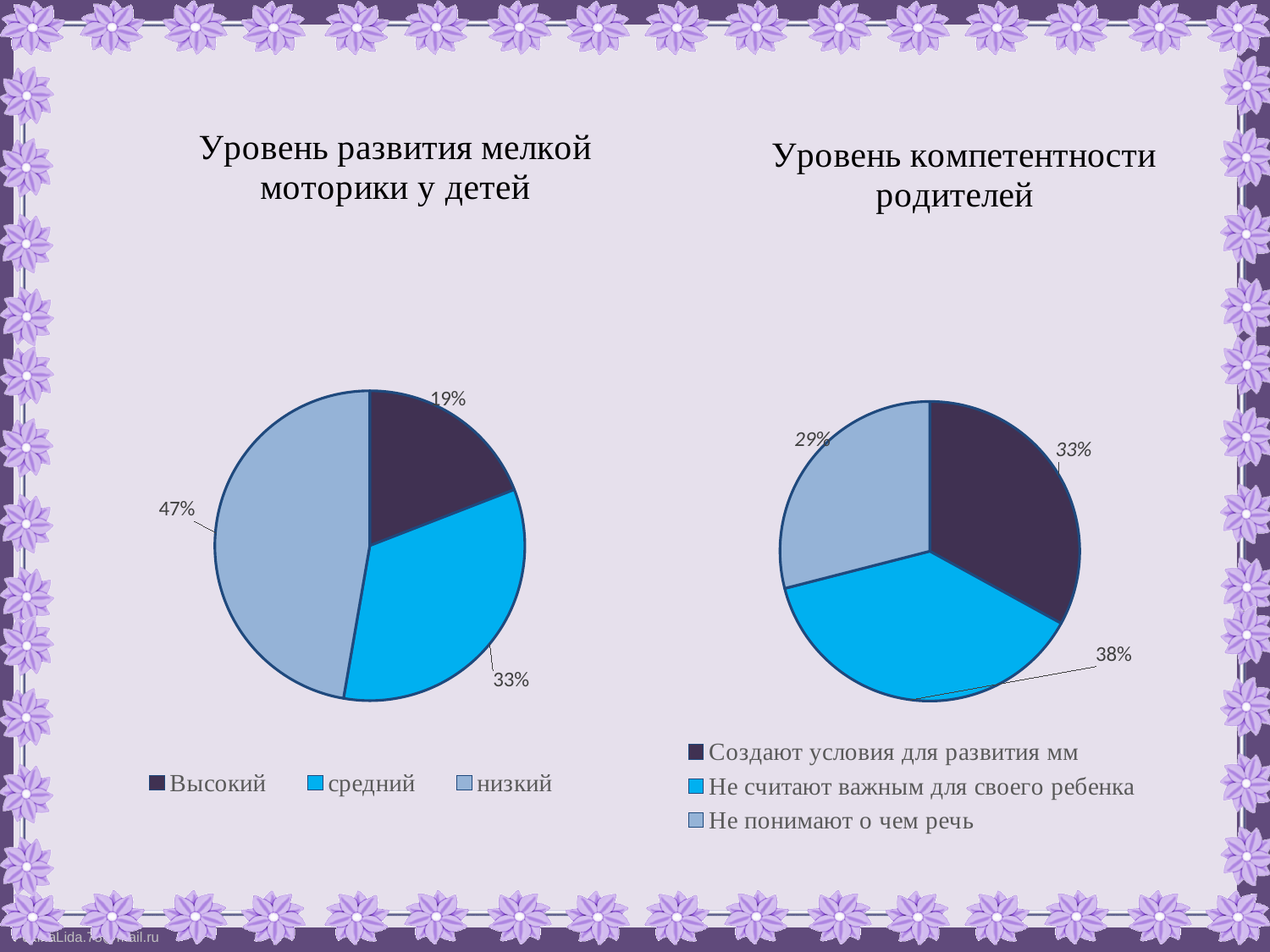
In the chart titled "Уровень компетентности родителей", which is larger: the share for "Создают условия для развития мм" or for "Не понимают о чем речь"? Создают условия для развития мм What kind of chart is the one titled "Уровень компетентности родителей"? Pie chart In the chart titled "Уровень развития мелкой моторики у детей", which category has the largest slice? низкий In the chart titled "Уровень развития мелкой моторики у детей", what is the difference between the shares for "низкий" and "средний"? 14% In the chart titled "Уровень компетентности родителей", which category has the largest slice? Не считают важным для своего ребенка In the chart titled "Уровень развития мелкой моторики у детей", what share is labelled for "низкий"? 47% In the chart titled "Уровень компетентности родителей", what share is labelled for "Не понимают о чем речь"? 29% In the chart titled "Уровень компетентности родителей", what share is labelled for "Не считают важным для своего ребенка"? 38% How many charts are shown on the slide? 2 In the chart titled "Уровень развития мелкой моторики у детей", which category has the smallest slice? Высокий In the chart titled "Уровень развития мелкой моторики у детей", what share is labelled for "Высокий"? 19% In the chart titled "Уровень развития мелкой моторики у детей", how many categories does the legend list? 3